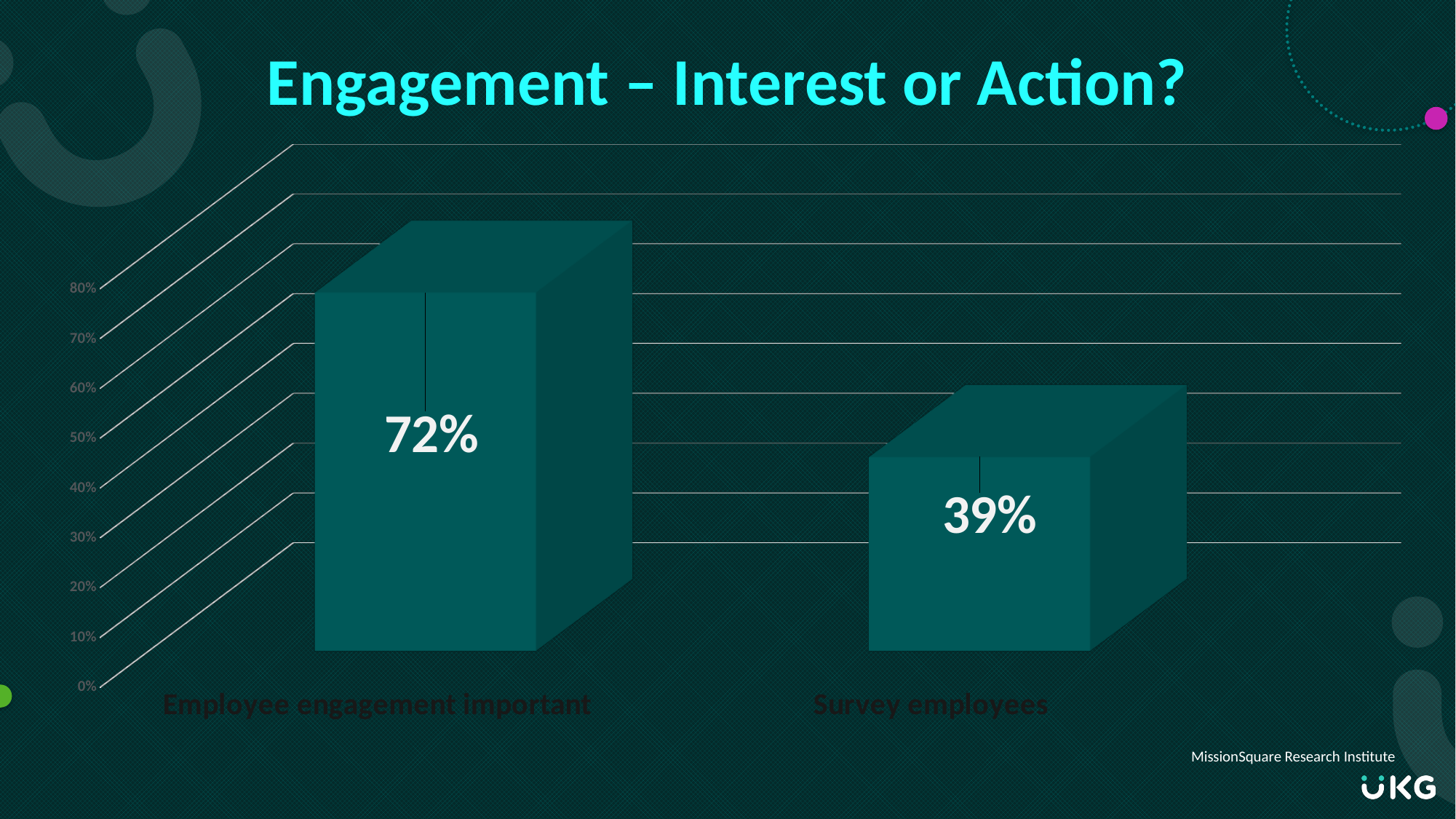
What is the difference between the values for Employee engagement important and Survey employees? 33% How many categories are shown in the chart? 2 What is the value for Survey employees? 39% Which category has the lowest value? Survey employees What is the value for Employee engagement important? 72% Which is larger, the value for Employee engagement important or the value for Survey employees? Employee engagement important What kind of chart is shown on the slide? bar chart Is the value for Employee engagement important greater or less than 60%? greater What is the highest value labelled on the vertical axis? 80% Is the value for Survey employees greater or less than 50%? less Which category has the highest value? Employee engagement important What is the title of the slide? Engagement – Interest or Action?